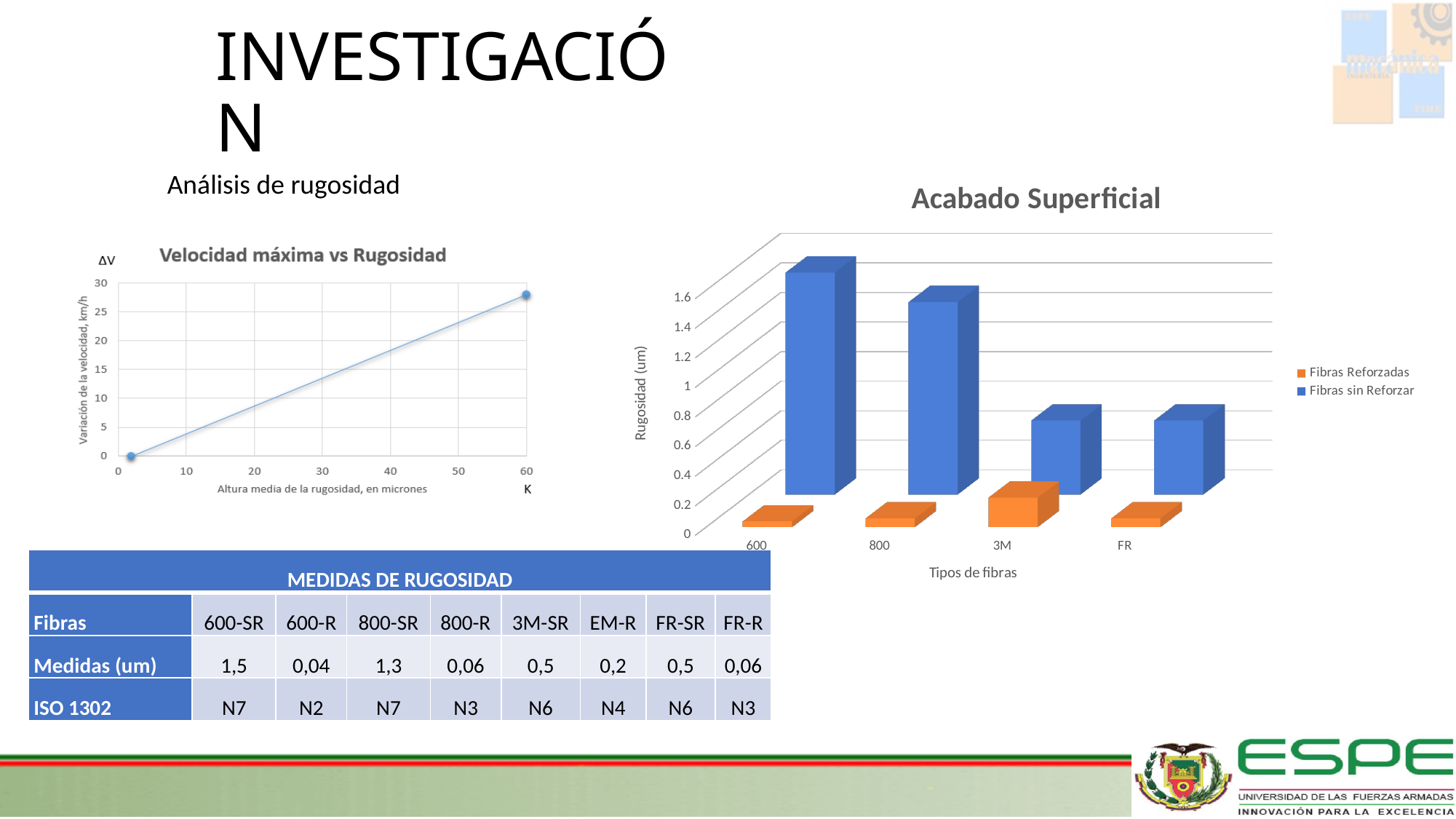
What type of chart is 'Velocidad máxima vs Rugosidad'? line chart How many series does the legend of the 'Acabado Superficial' chart list? 2 In the 'Acabado Superficial' chart, which fibre type has the highest value for Fibras sin Reforzar? 600 In the 'Acabado Superficial' chart, which is larger for Fibras sin Reforzar: 600 or 800? 600 In the 'Acabado Superficial' chart, is the Fibras sin Reforzar value for 3M greater or less than 1? less In the 'Acabado Superficial' chart, which fibre type has the highest value for Fibras Reforzadas? 3M In the 'Acabado Superficial' chart, is the Fibras Reforzadas value for 600 greater or less than 0.2? less How many fibre type categories are shown on the x axis of the 'Acabado Superficial' chart? 4 In the 'Acabado Superficial' chart, is the Fibras sin Reforzar value for 600 greater or less than 1? greater What type of chart is the 'Acabado Superficial' chart? bar chart What is the y-axis title of the 'Acabado Superficial' chart? Rugosidad (um) In the 'Velocidad máxima vs Rugosidad' chart, does the line rise or fall as the x-axis value increases? rise